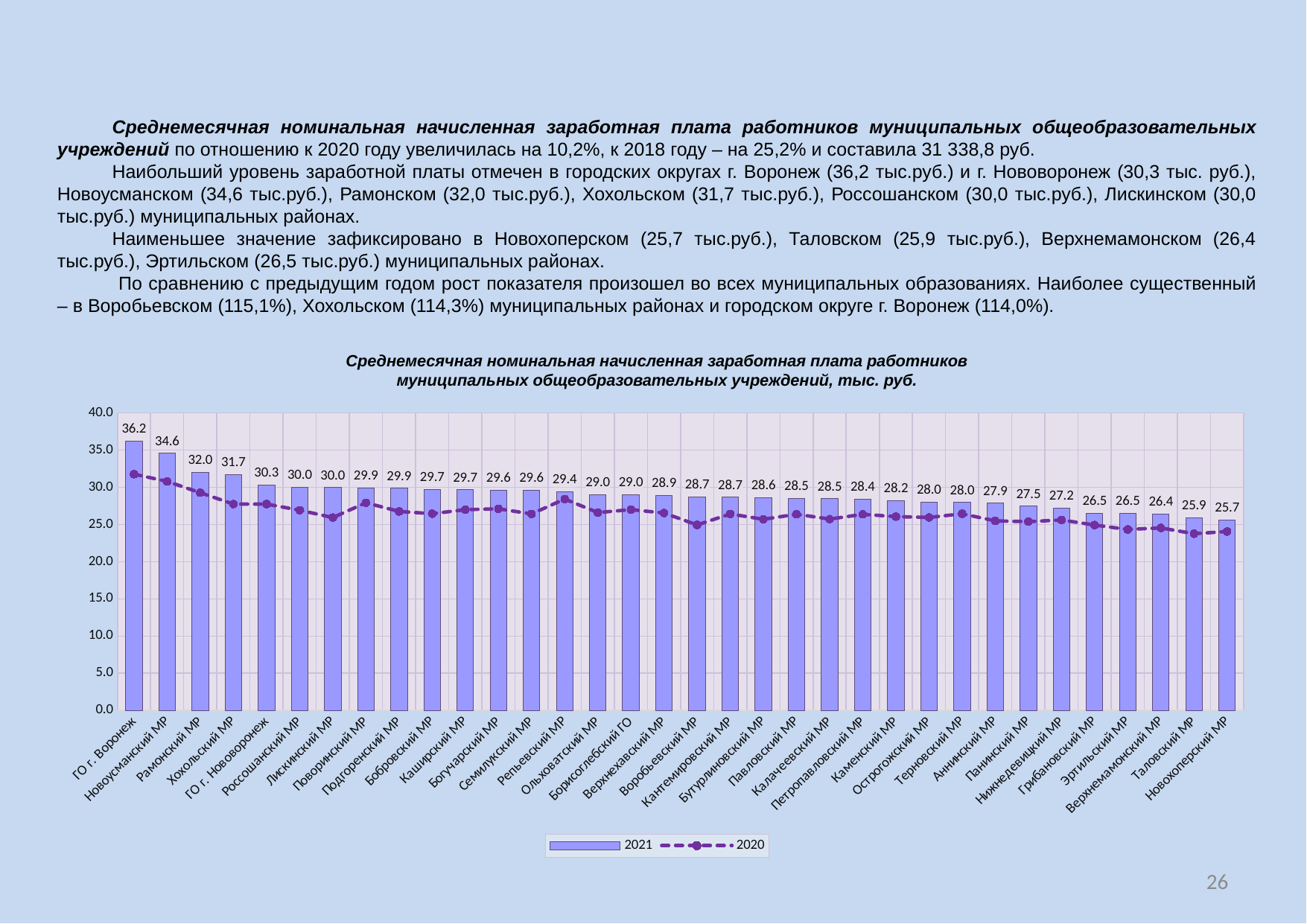
Is the 2020 value for ГО г. Воронеж greater or less than 30.0? greater What is the difference between the 2021 values for ГО г. Воронеж and Новоусманский МР? 1.6 Which category has the highest 2021 value? ГО г. Воронеж How many categories are shown on the x axis? 34 What is the 2021 value for Верхнемамонский МР? 26.4 Which category has the lowest 2021 value? Новохоперский МР What is the 2021 value for Хохольский МР? 31.7 Do the 2021 bar values rise or fall from left to right along the x axis? fall Is the 2020 value for Новохоперский МР greater or less than 25.0? less What is the 2021 value for ГО г. Воронеж? 36.2 How many series does the legend list? 2 Which has the larger 2021 value, Рамонский МР or ГО г. Нововоронеж? Рамонский МР